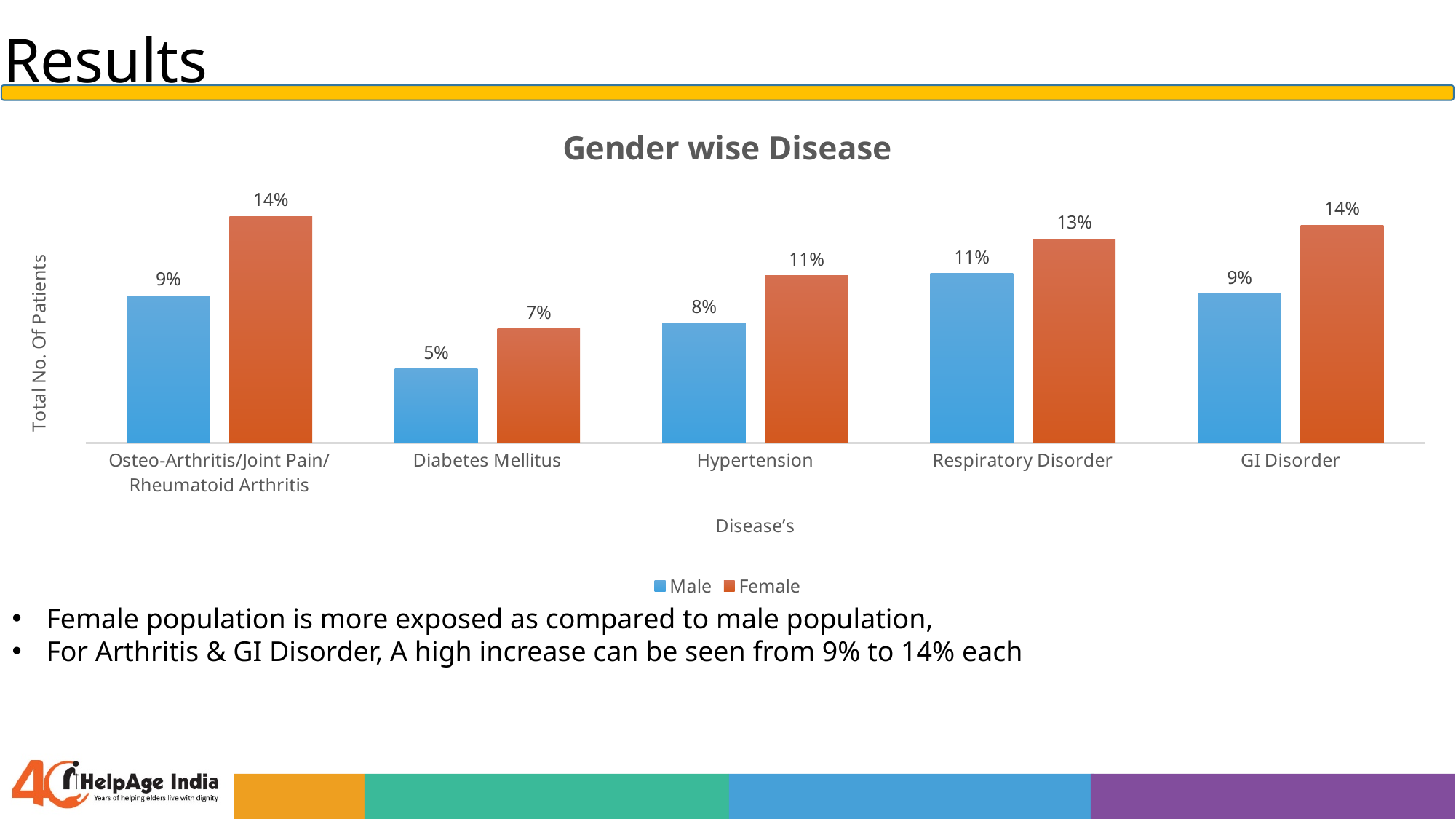
Which disease has the lowest Male value? Diabetes Mellitus What is the Female value for Diabetes Mellitus? 7% Which is larger, the Male value for Hypertension or the Male value for GI Disorder? GI Disorder What is the difference between the Female values for Respiratory Disorder and Diabetes Mellitus? 6% How many disease categories are shown on the x axis? 5 Which disease has the highest Male value? Respiratory Disorder What is the Male value for Hypertension? 8% What kind of chart is shown? Bar chart How many series does the legend list? 2 What is the title of the chart? Gender wise Disease What is the difference between the Female and Male values for GI Disorder? 5% What is the Female value for Respiratory Disorder? 13%